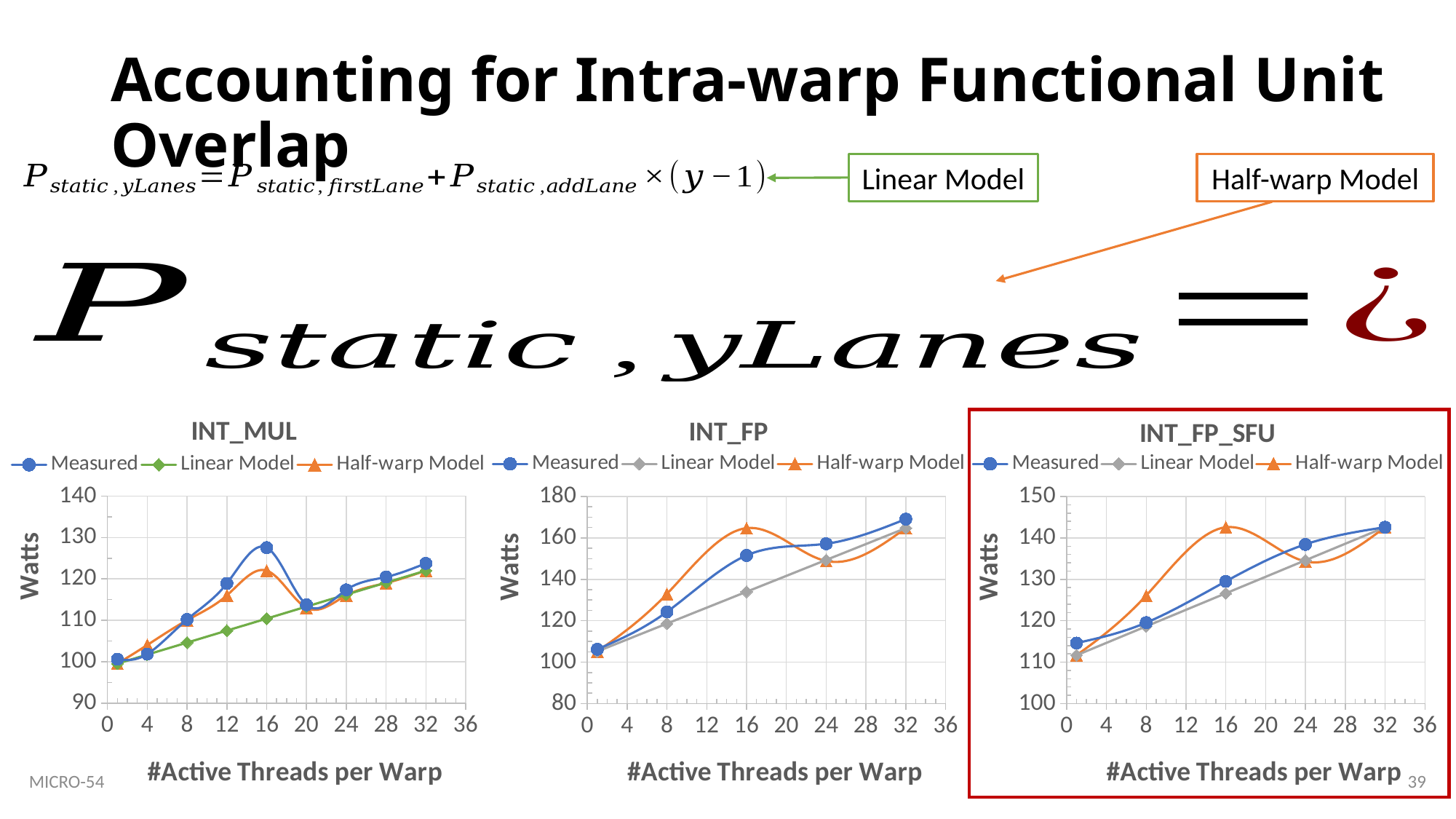
In the INT_MUL chart, is the Measured value at 16 active threads per warp greater or less than 120? greater What kind of chart is the INT_MUL chart? line chart In the INT_FP chart, does the Linear Model series rise or fall as the number of active threads per warp increases? rise In the INT_MUL chart, is the Linear Model value at 16 active threads per warp greater or less than 120? less What are the legend entries of the INT_FP_SFU chart? Measured, Linear Model, Half-warp Model In the INT_FP chart, is the Measured value at 32 active threads per warp greater or less than 160? greater In the INT_FP_SFU chart, at 16 active threads per warp, which is larger: the Half-warp Model value or the Linear Model value? Half-warp Model In the INT_MUL chart, at 16 active threads per warp, which is larger: the Measured value or the Linear Model value? Measured What is the y-axis label of the INT_MUL chart? Watts How many series does the legend of the INT_FP chart list? 3